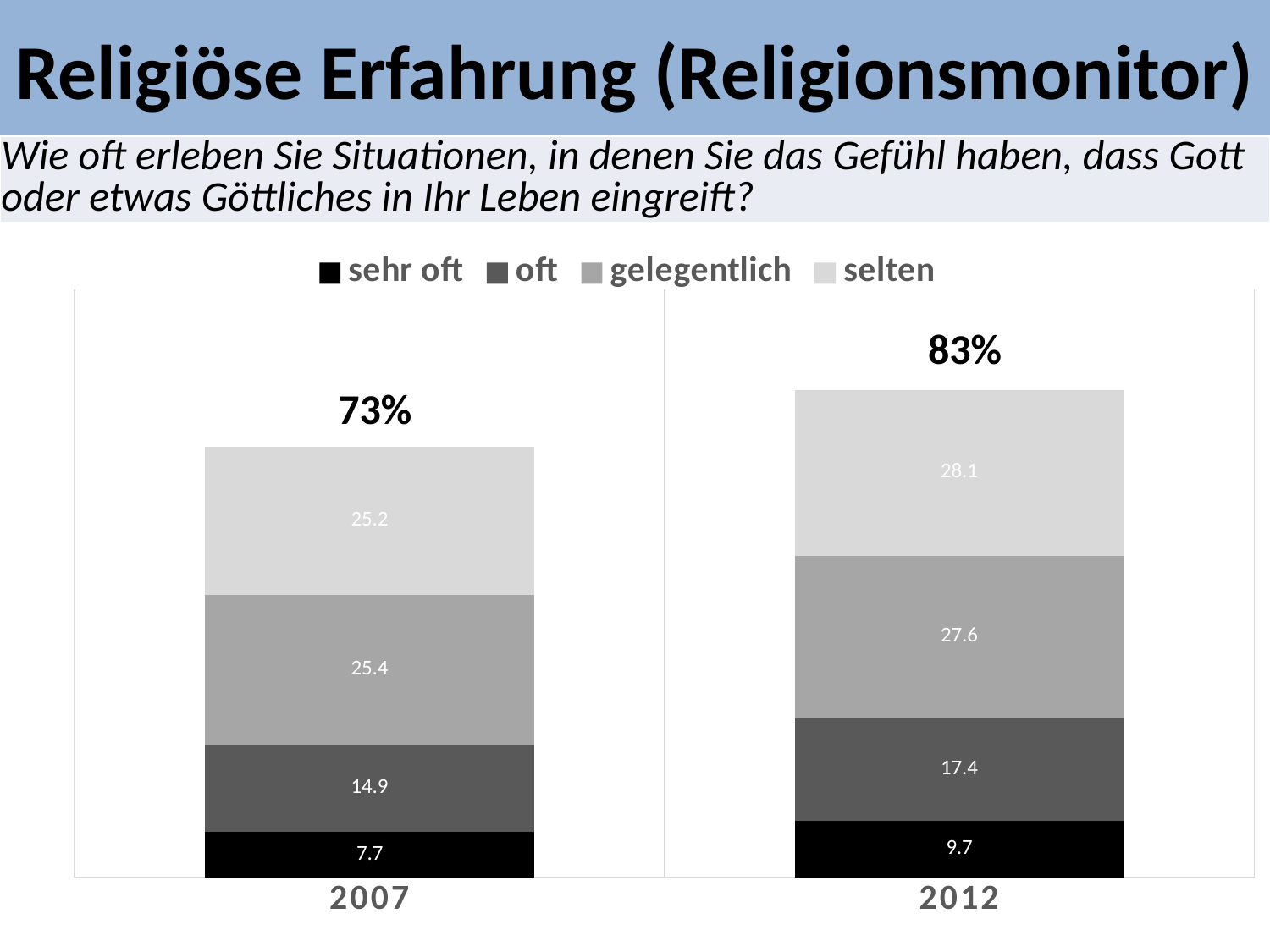
How many series does the legend list? 4 How many categories are shown on the x axis? 2 What is the value for "gelegentlich" in 2007? 25.4 What total percentage is printed above the 2007 bar? 73% What is the value for "sehr oft" in 2007? 7.7 Which series is listed first in the legend? sehr oft What kind of chart is shown on the slide? stacked bar chart What is the value for "selten" in 2012? 28.1 What is the difference between the "oft" values for 2012 and 2007? 2.5 What total percentage is printed above the 2012 bar? 83% Which year has the larger value for "sehr oft", 2007 or 2012? 2012 What is the value for "oft" in 2012? 17.4